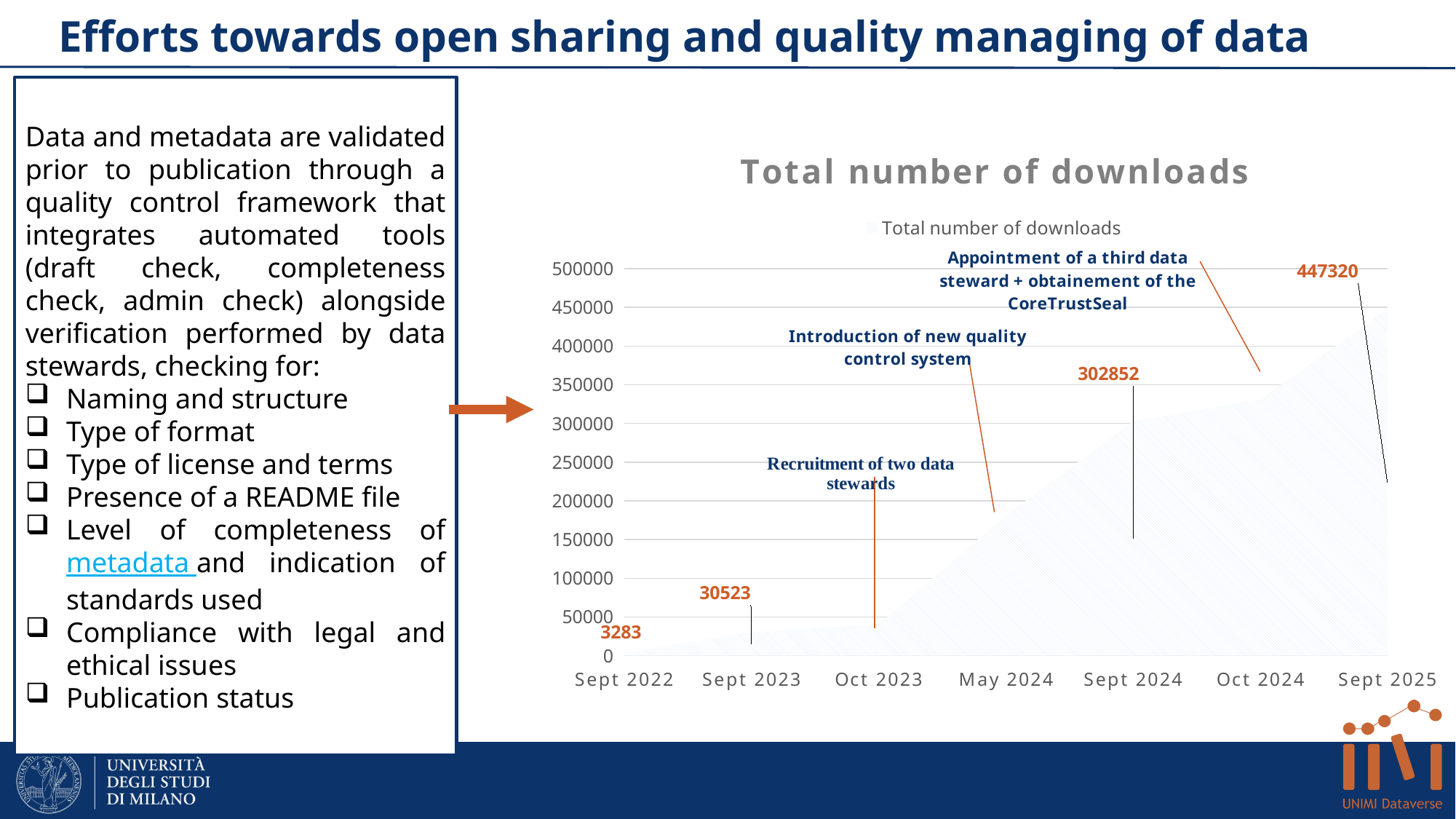
What is the total number of downloads for Sept 2024? 302852 What is the total number of downloads for Sept 2025? 447320 How many categories are shown on the x axis of the chart? 7 What is the title of the chart? Total number of downloads What is the total number of downloads for Sept 2022? 3283 What is the total number of downloads for Sept 2023? 30523 Do the values rise or fall along the x axis from Sept 2022 to Sept 2025? Rise What is the difference in total number of downloads between Sept 2025 and Sept 2024? 144468 Which category has the lowest total number of downloads? Sept 2022 Which category has the highest total number of downloads? Sept 2025 How many series does the chart legend list? 1 What kind of chart is shown on the slide? Area chart